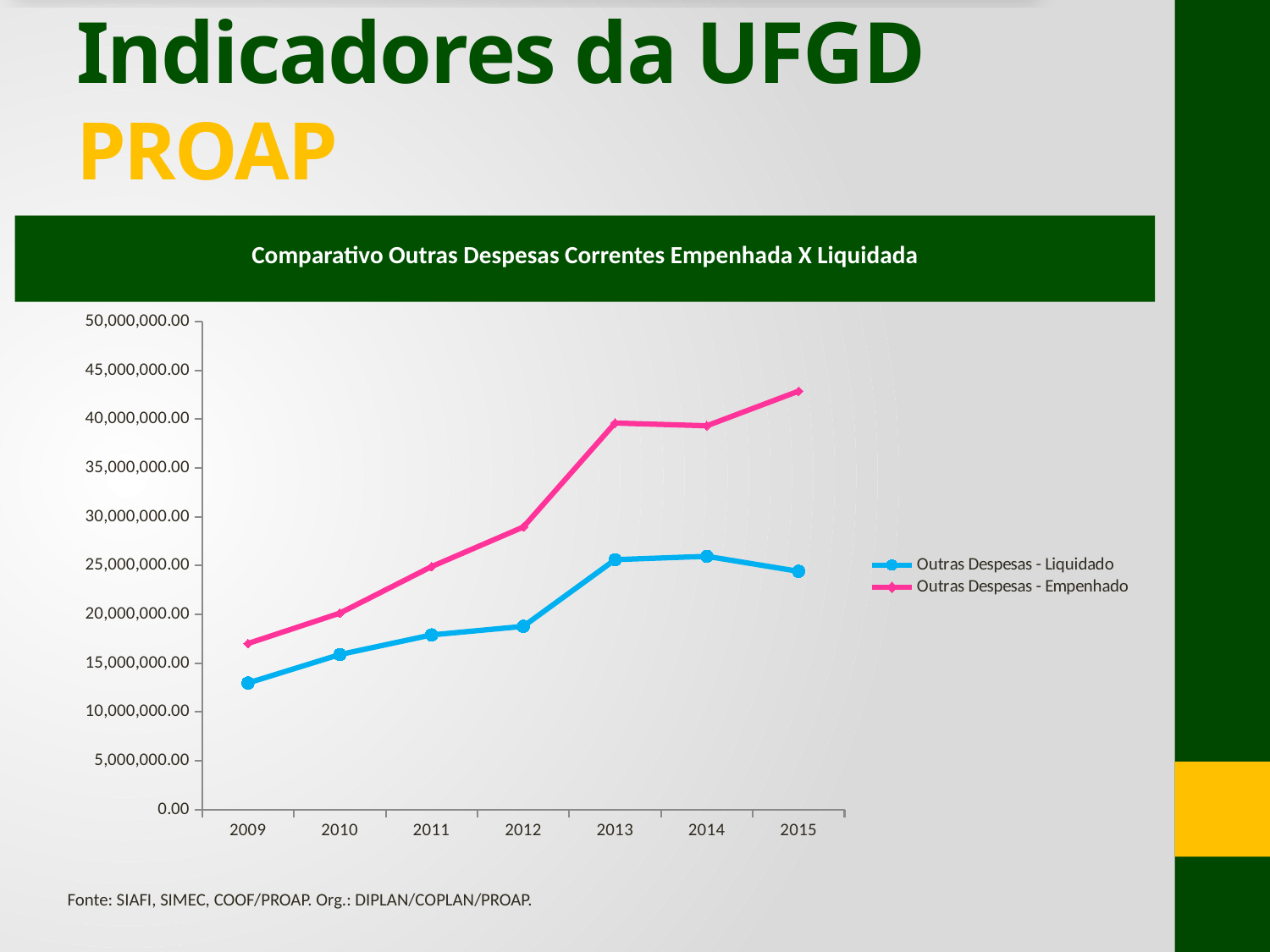
In which year is the value for Outras Despesas - Empenhado highest? 2015 Does the value for Outras Despesas - Liquidado rise or fall from 2014 to 2015? fall Is the value for Outras Despesas - Liquidado in 2012 greater or less than 20,000,000.00? less Is the value for Outras Despesas - Liquidado in 2009 greater or less than 15,000,000.00? less Is the value for Outras Despesas - Empenhado in 2015 greater or less than 40,000,000.00? greater What kind of chart is shown on the slide? line chart In 2015, which series has the larger value, Outras Despesas - Empenhado or Outras Despesas - Liquidado? Outras Despesas - Empenhado Which series is drawn in pink? Outras Despesas - Empenhado What is the title of the chart? Comparativo Outras Despesas Correntes Empenhada X Liquidada How many series does the legend list? 2 How many years are plotted along the x axis? 7 In which year is the value for Outras Despesas - Liquidado lowest? 2009